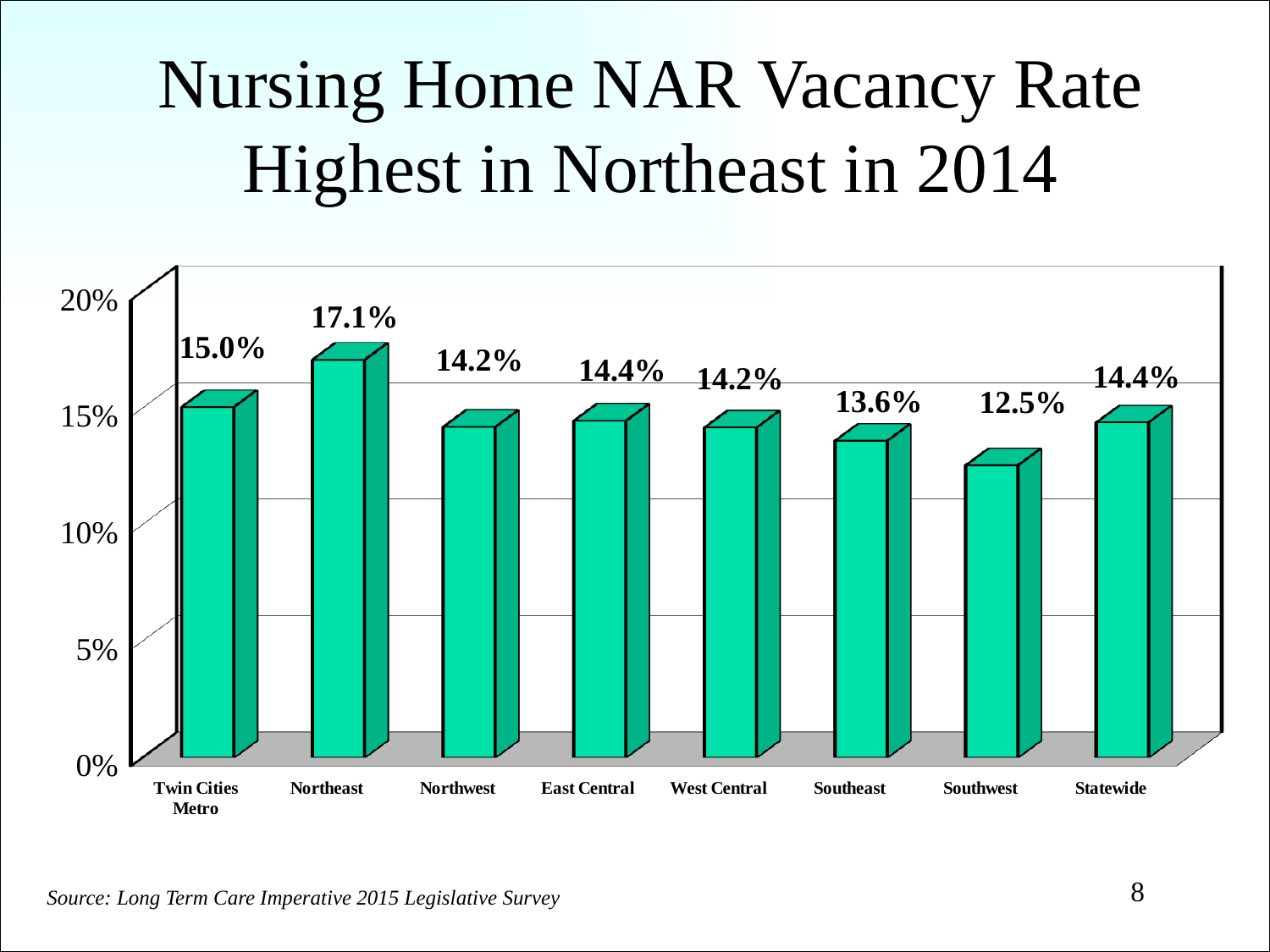
How much higher is the Twin Cities Metro vacancy rate than the Southeast rate? 1.4% What is the Statewide vacancy rate shown on the chart? 14.4% Which region has the lowest vacancy rate? Southwest What kind of chart is shown on the slide? Bar chart Which has a higher vacancy rate, Twin Cities Metro or East Central? Twin Cities Metro What is the nursing home NAR vacancy rate for the Northeast region? 17.1% Is the vacancy rate for Southwest greater or less than 15%? less How many regions (categories) are shown on the chart? 8 Which region has the highest vacancy rate? Northeast What is the vacancy rate shown for Twin Cities Metro? 15.0% What is the difference between the Northeast and Southwest vacancy rates? 4.6% What is the vacancy rate for the Southeast region? 13.6%